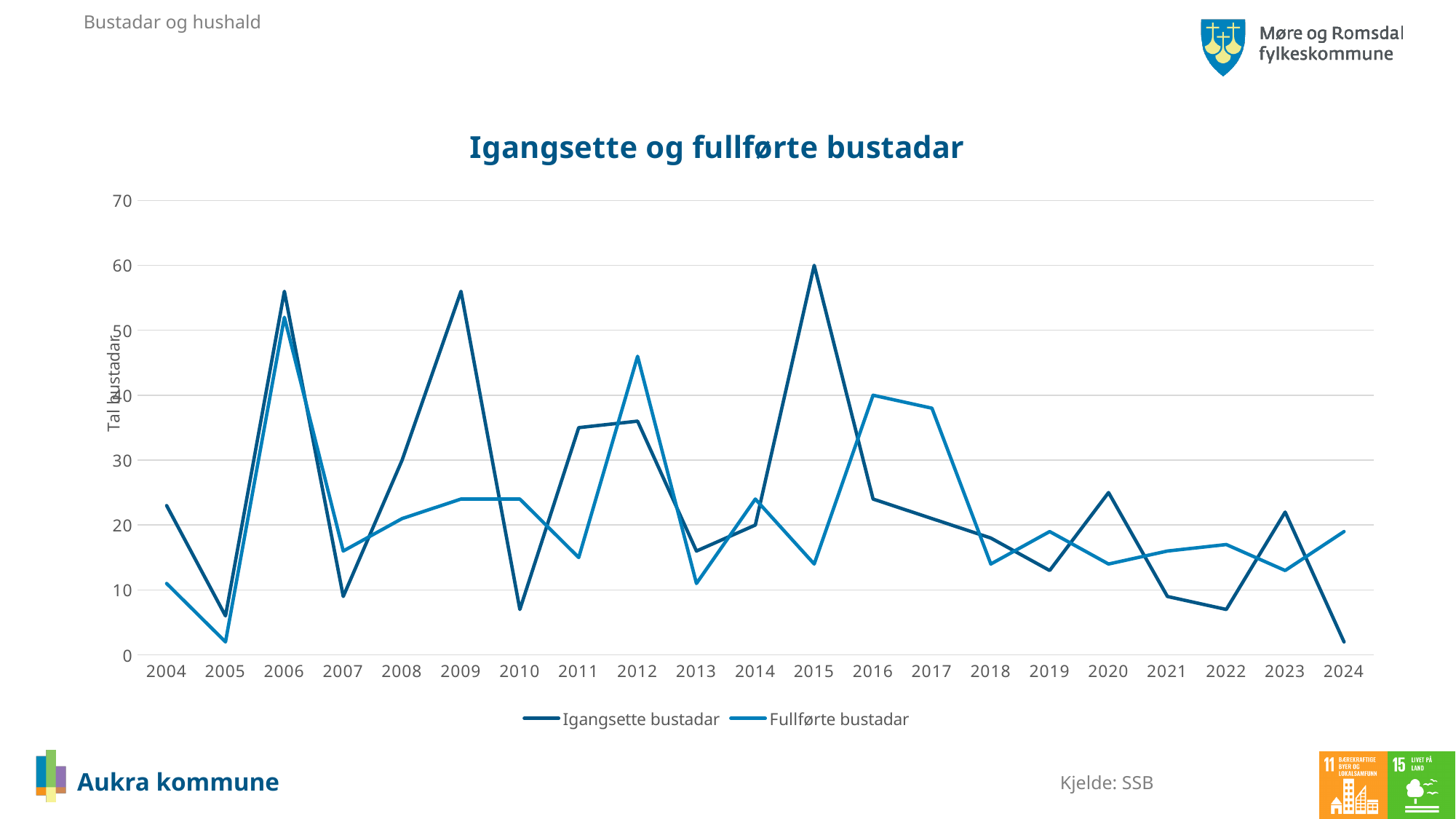
In which year does the Fullførte bustadar series reach its highest value? 2006 In which year does the Igangsette bustadar series reach its highest value? 2015 What is the value of Igangsette bustadar in 2015? 60 Is the value for Igangsette bustadar in 2009 greater or less than 50? greater What kind of chart is shown on the slide? Line chart What is the value of Fullførte bustadar in 2016? 40 In 2017, which series has the larger value, Igangsette bustadar or Fullførte bustadar? Fullførte bustadar Is the value for Fullførte bustadar in 2005 greater or less than 10? less In which year is the Fullførte bustadar series at its lowest? 2005 What is the title of the chart? Igangsette og fullførte bustadar How many series does the legend list? 2 How many years are plotted along the x axis? 21